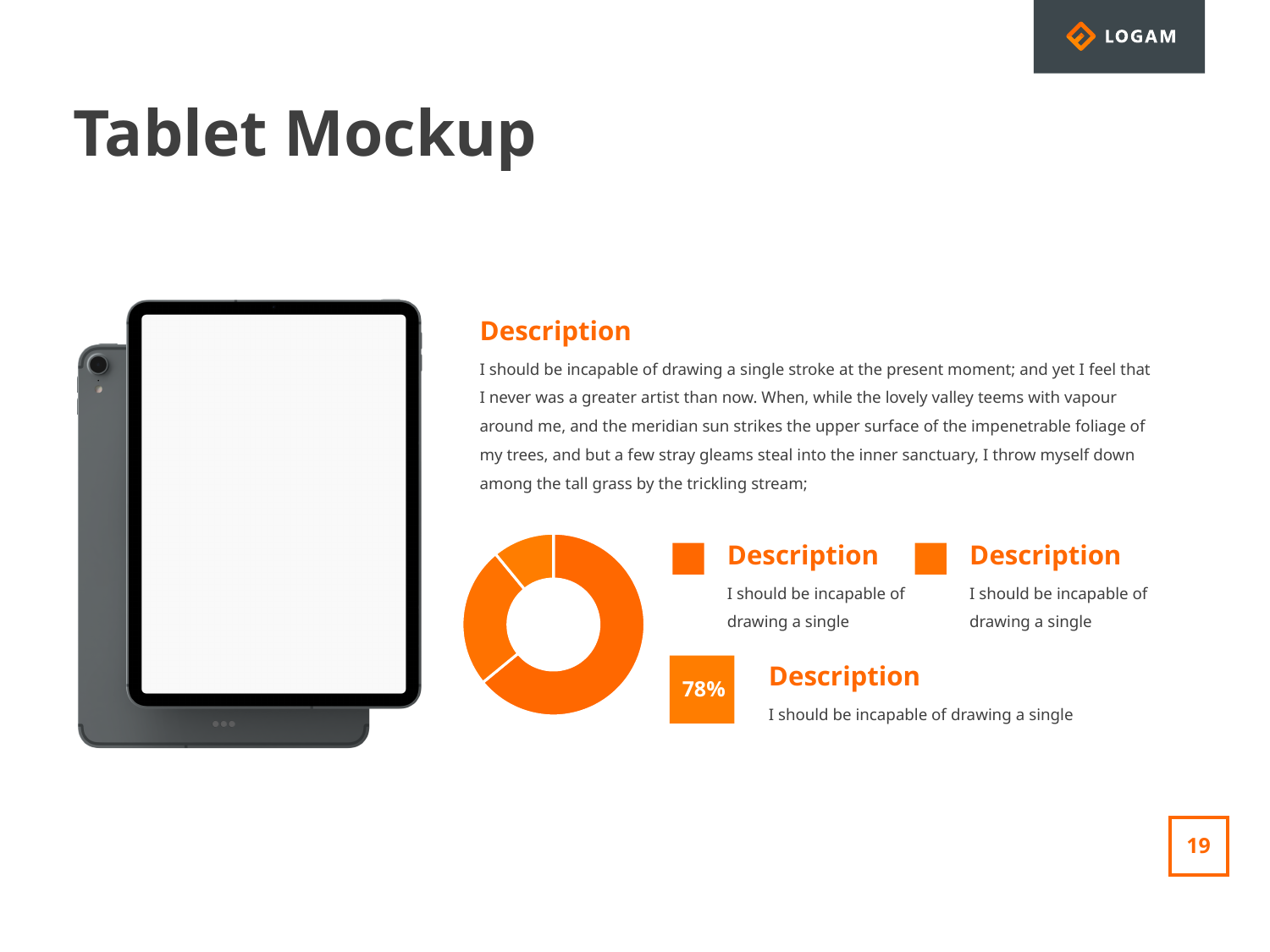
What kind of chart is shown on the slide? doughnut chart Does the doughnut chart have a legend? No What colour is the largest slice of the doughnut chart? dark orange How many slices does the doughnut chart have? 3 Which slice of the doughnut chart is the largest? the dark orange slice